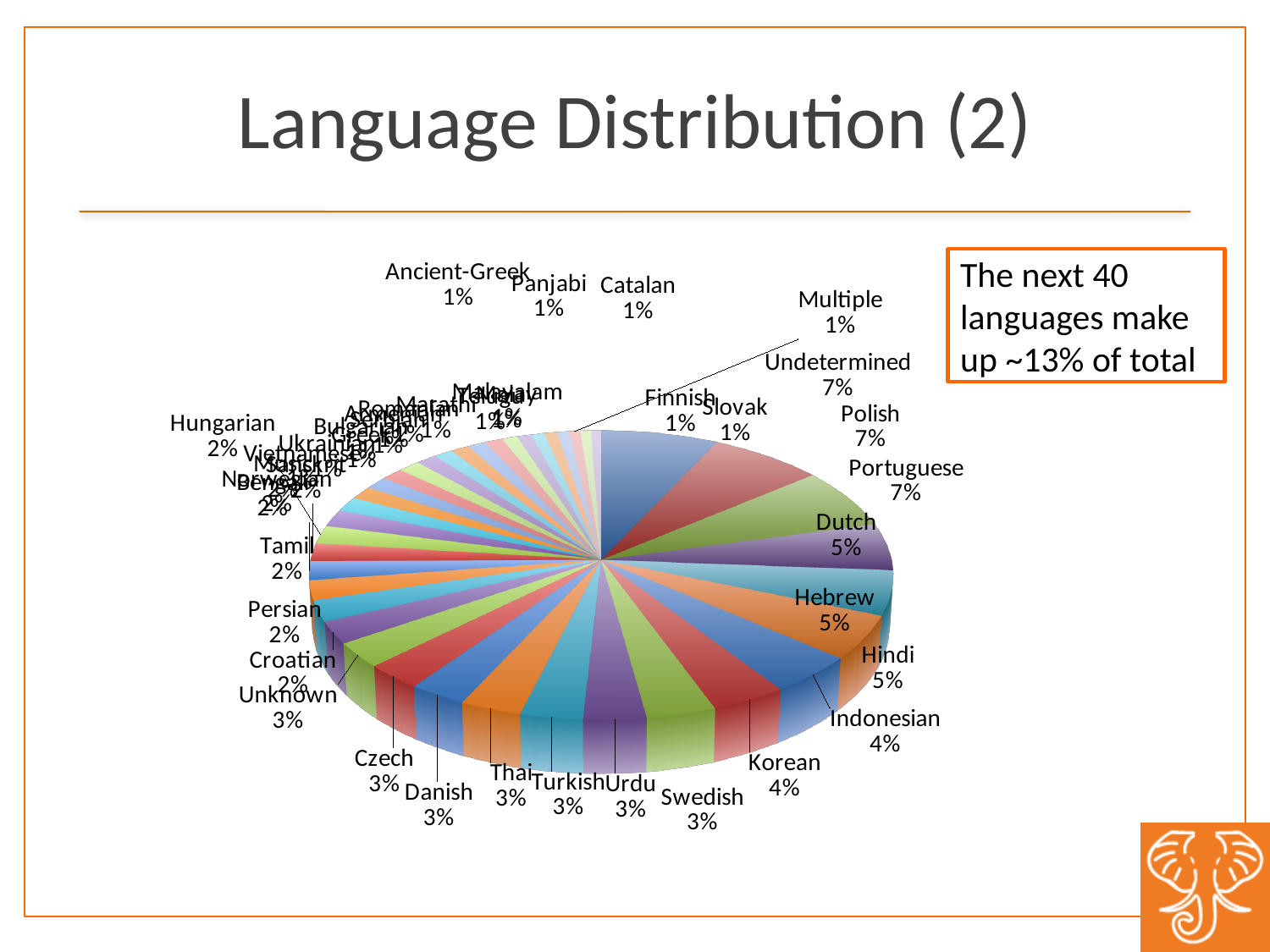
Which is larger, the share for Korean or the share for Tamil? Korean What is the difference between the share for Undetermined and the share for Hindi? 2% According to the text box on the slide, roughly what share of the total do the next 40 languages make up? ~13% What is the value shown for Dutch? 5% What is the value shown for Indonesian? 4% What is the value shown for Persian? 2% Which is larger, the share for Portuguese or the share for Hebrew? Portuguese What is the value shown for Catalan? 1% What type of chart is shown on the slide? pie chart What is the title of the slide containing the chart? Language Distribution (2) What is the value shown for Unknown? 3% What share of the pie does Polish account for? 7%